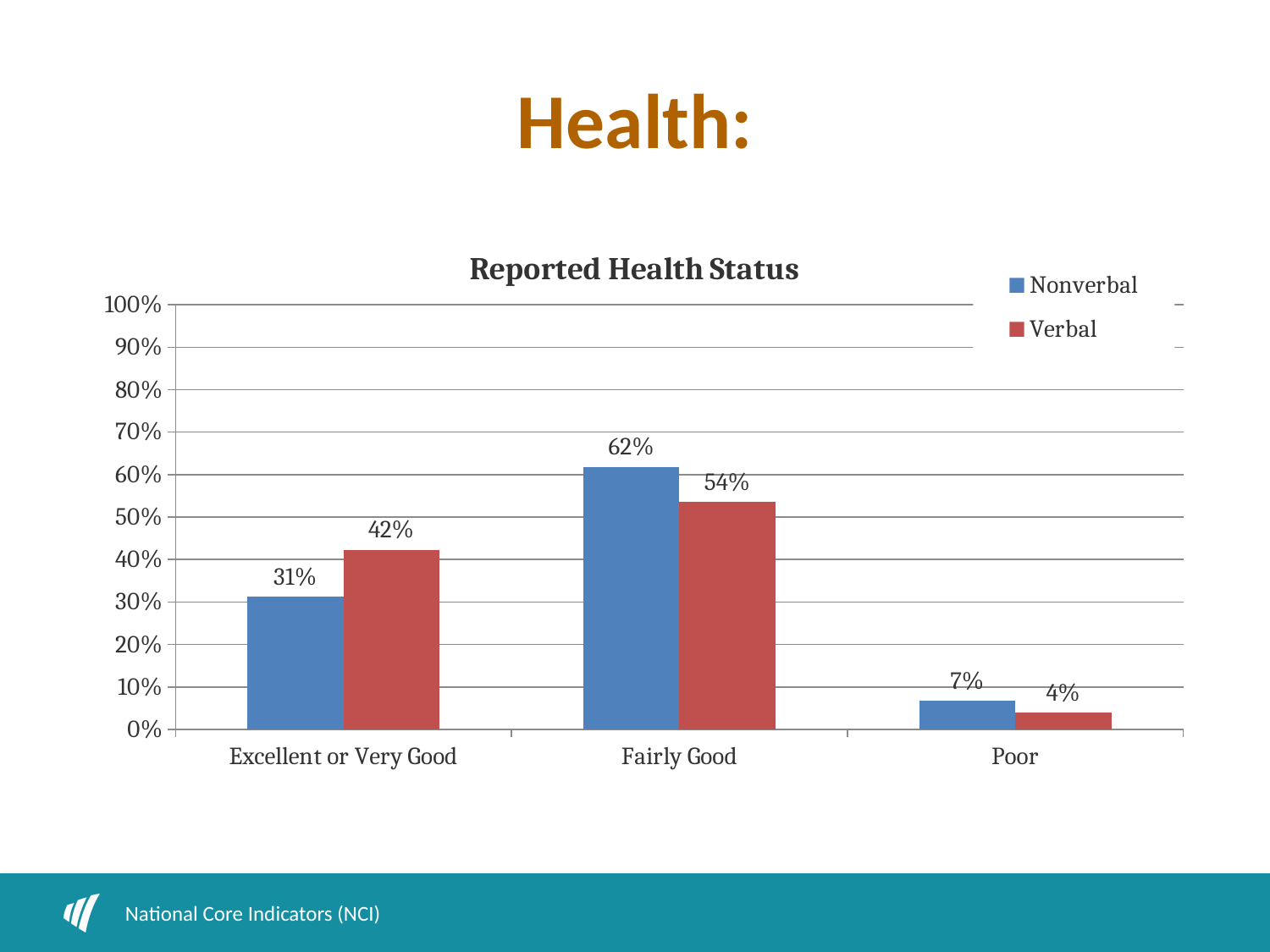
What is the Verbal value for Excellent or Very Good? 42% What is the Verbal value for Poor? 4% What is the difference between the Verbal and Nonverbal values for Excellent or Very Good? 11% What kind of chart is shown? Bar chart How many categories are shown on the x axis? 3 Which category has the lowest Verbal value? Poor For Poor, which series has the larger value, Nonverbal or Verbal? Nonverbal Which category has the highest Nonverbal value? Fairly Good What is the title of the chart? Reported Health Status What is the Nonverbal value for Fairly Good? 62% What is the difference between the Nonverbal and Verbal values for Fairly Good? 8% How many series does the legend list? 2